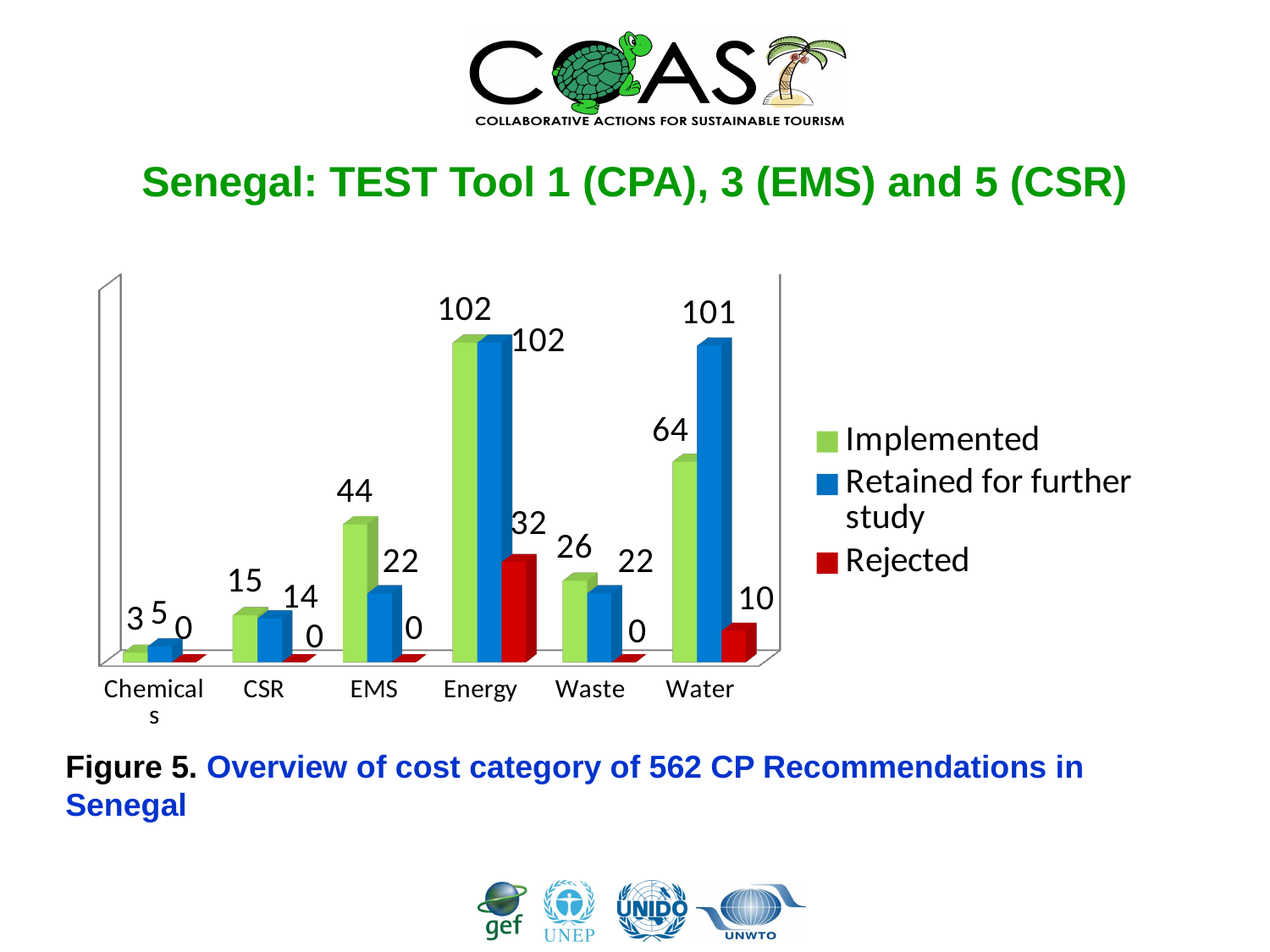
Which colour represents the Rejected series in the legend? Red Which category has the highest Implemented value? Energy Which category has the lowest Implemented value? Chemicals How many series does the legend list? 3 What kind of chart is shown on the slide? Bar chart What is the Implemented value for EMS? 44 What is the Rejected value for Energy? 32 Which is larger for EMS: the Implemented value or the Retained for further study value? Implemented What is the Retained for further study value for Water? 101 How many categories are shown on the x axis? 6 What is the Implemented value for Waste? 26 What is the difference between the Implemented and Retained for further study values for Water? 37